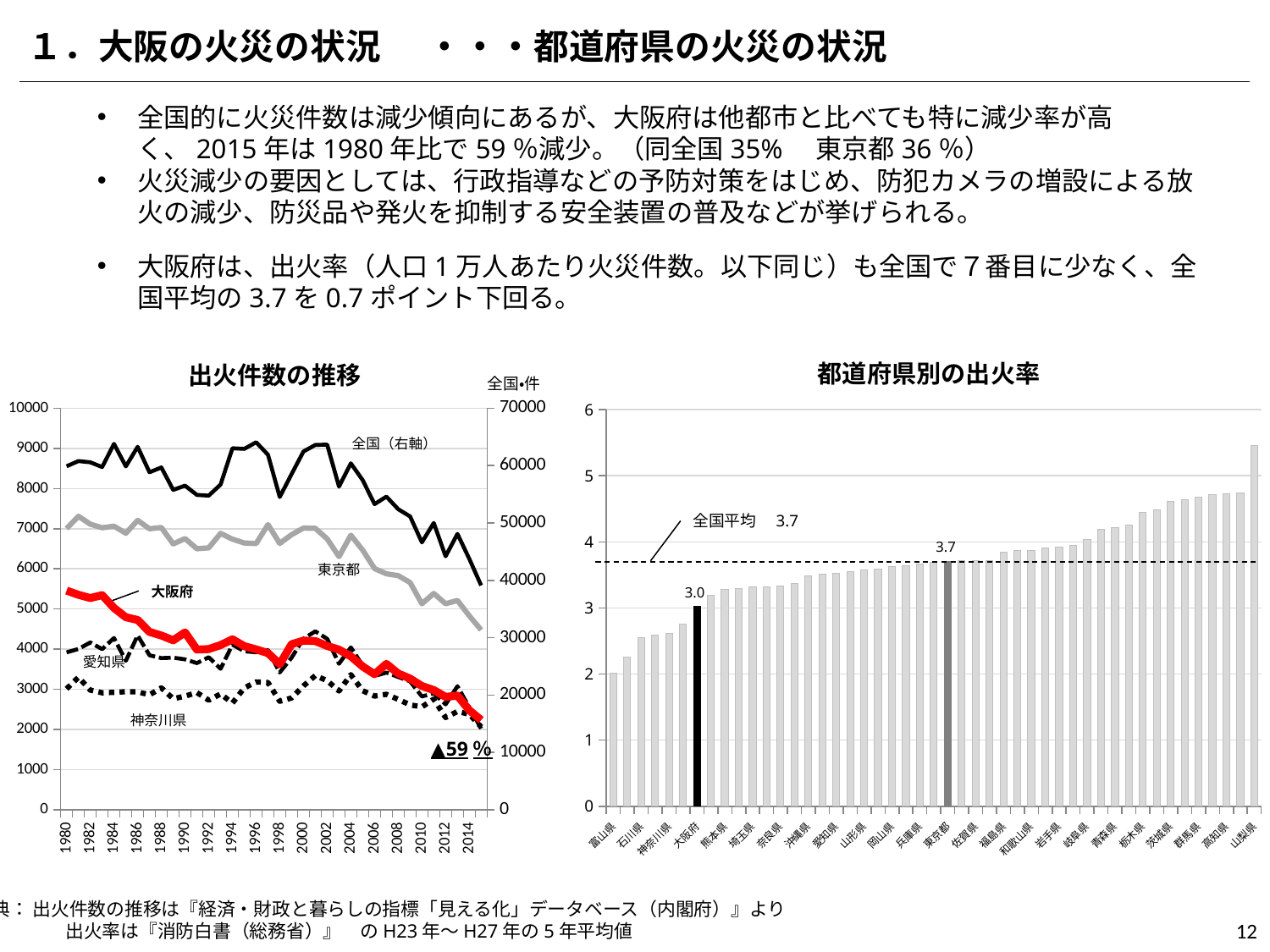
In the 都道府県別の出火率 chart, which prefecture has the lowest value? 富山県 In the 都道府県別の出火率 chart, what value is given for the 全国平均 dashed line? 3.7 In the 都道府県別の出火率 chart, what is the difference between the values for 東京都 and 大阪府? 0.7 In the 都道府県別の出火率 chart, what is the value shown for 大阪府? 3.0 In the 都道府県別の出火率 chart, what is the value shown for 東京都? 3.7 What kind of chart is the 都道府県別の出火率 chart on the right? bar chart In the 都道府県別の出火率 chart, which prefecture has the highest value? 山梨県 What kind of chart is the 出火件数の推移 chart on the left? line chart In the 都道府県別の出火率 chart, is the value for 山梨県 greater or less than 5? greater In the 出火件数の推移 chart, does the 全国 line generally rise or fall from 1980 to 2015? fall In the 都道府県別の出火率 chart, is the value for 富山県 greater or less than 3? less In the 都道府県別の出火率 chart, which has the larger value, 大阪府 or 東京都? 東京都